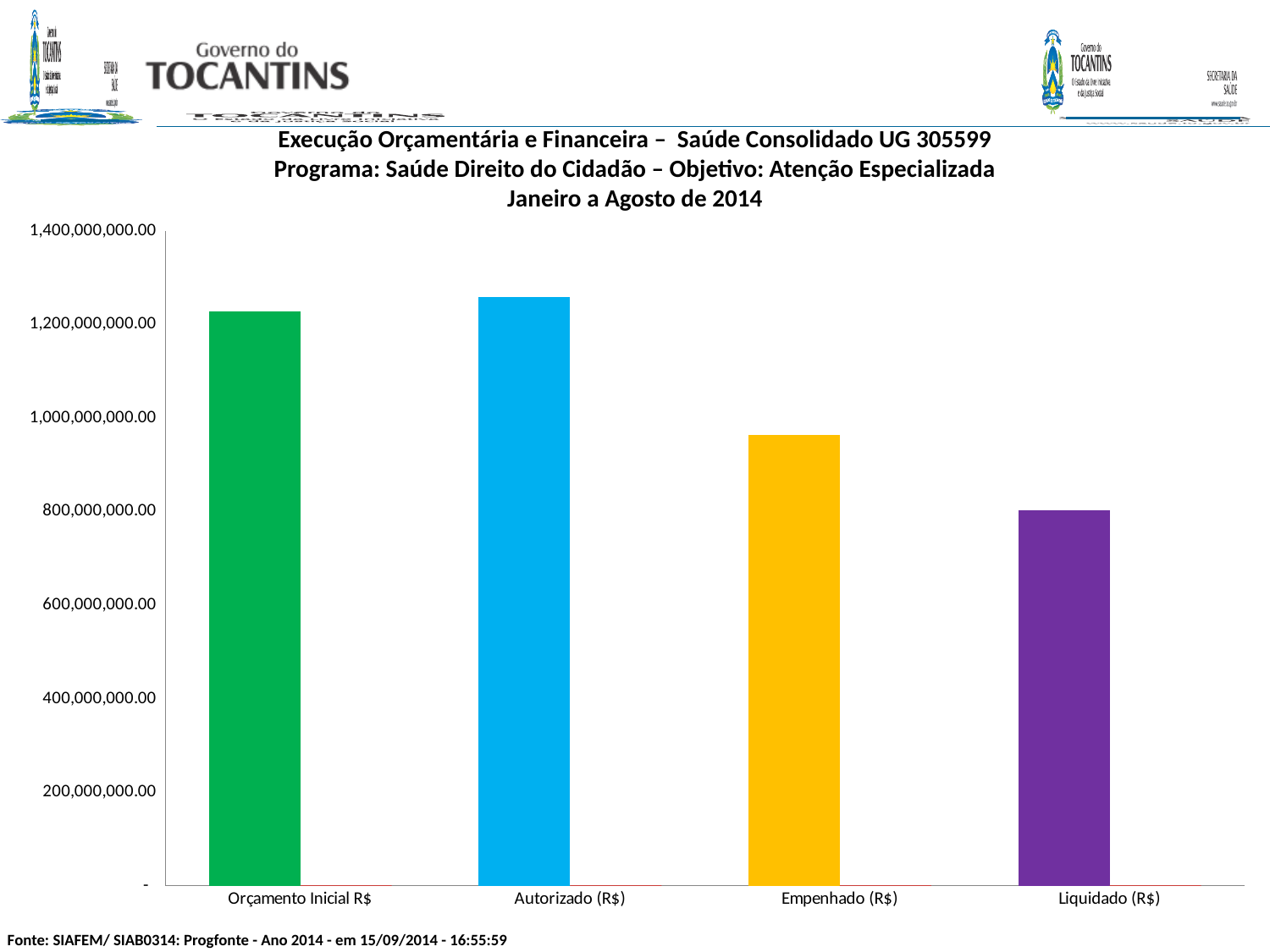
Which is larger, Autorizado (R$) or Empenhado (R$)? Autorizado (R$) Is the value for Autorizado (R$) greater or less than 1,200,000,000.00? greater Is the value for Empenhado (R$) greater or less than 1,000,000,000.00? less Which category has the lowest value? Liquidado (R$) What kind of chart is shown on the slide? bar chart What colour is the bar for Empenhado (R$)? yellow Which is larger, Empenhado (R$) or Liquidado (R$)? Empenhado (R$) How many categories are plotted on the chart? 4 What period does the chart title say the data covers? Janeiro a Agosto de 2014 From Autorizado (R$) to Liquidado (R$), do the values rise or fall along the x axis? fall Is the value for Empenhado (R$) greater or less than 800,000,000.00? greater